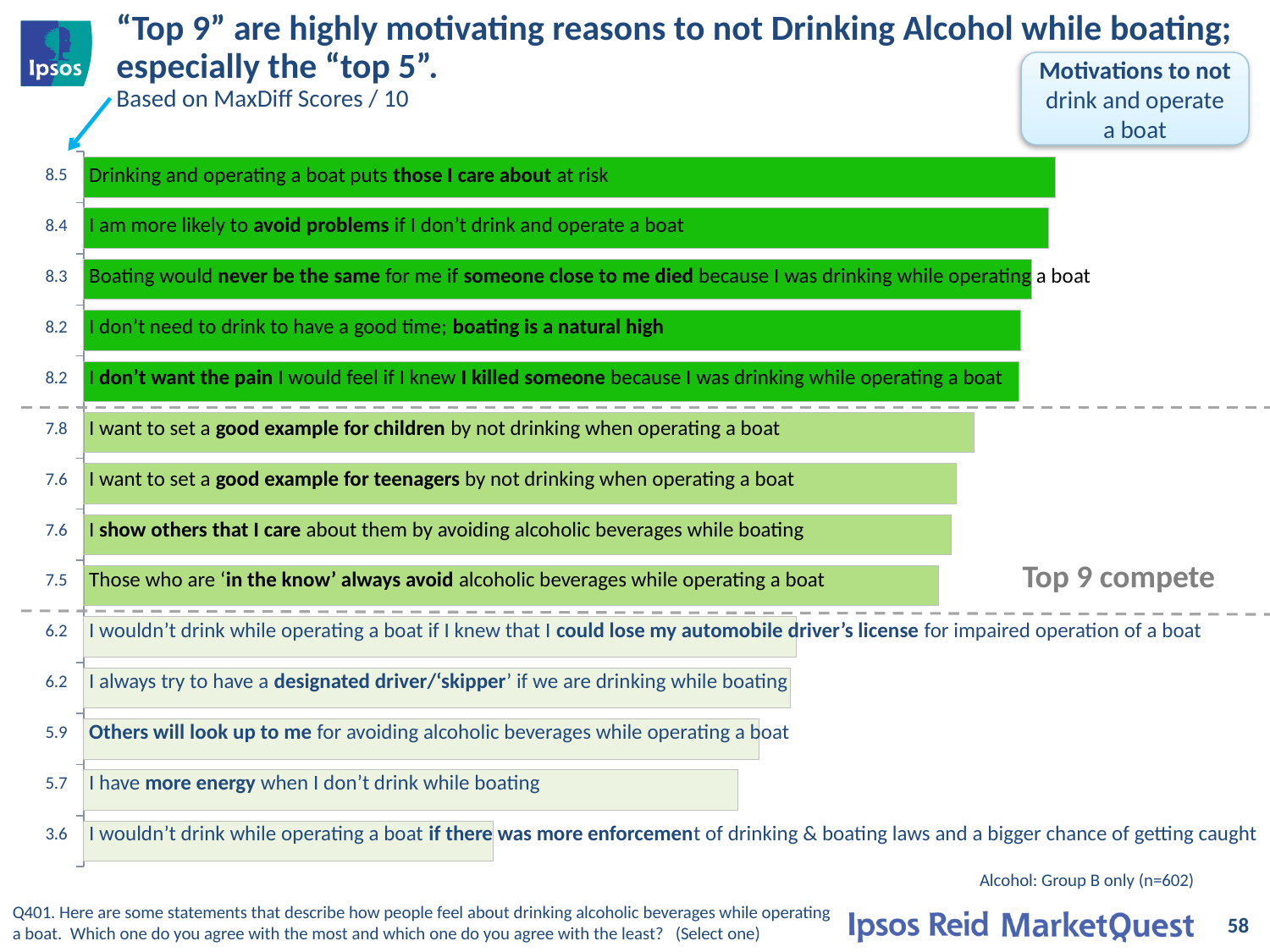
What type of chart is used on this slide? Bar chart What is the MaxDiff score for "I have more energy when I don't drink while boating"? 5.7 What scale are the MaxDiff scores in the chart based on, according to the subtitle? MaxDiff Scores / 10 What is the MaxDiff score for "I want to set a good example for children by not drinking when operating a boat"? 7.8 What is the MaxDiff score for "I wouldn't drink while operating a boat if I knew that I could lose my automobile driver's license for impaired operation of a boat"? 6.2 What is the MaxDiff score for "Drinking and operating a boat puts those I care about at risk"? 8.5 How many statements (bars) are shown in the chart? 14 Which statement has the lowest MaxDiff score? I wouldn't drink while operating a boat if there was more enforcement of drinking & boating laws and a bigger chance of getting caught Which statement has the highest MaxDiff score? Drinking and operating a boat puts those I care about at risk What is the difference in MaxDiff score between "I want to set a good example for children" (7.8) and "Others will look up to me for avoiding alcoholic beverages while operating a boat" (5.9)? 1.9 Which has a higher MaxDiff score: "I am more likely to avoid problems if I don't drink and operate a boat" or "I always try to have a designated driver/'skipper' if we are drinking while boating"? I am more likely to avoid problems if I don't drink and operate a boat What is the difference between the highest MaxDiff score (8.5) and the lowest (3.6)? 4.9